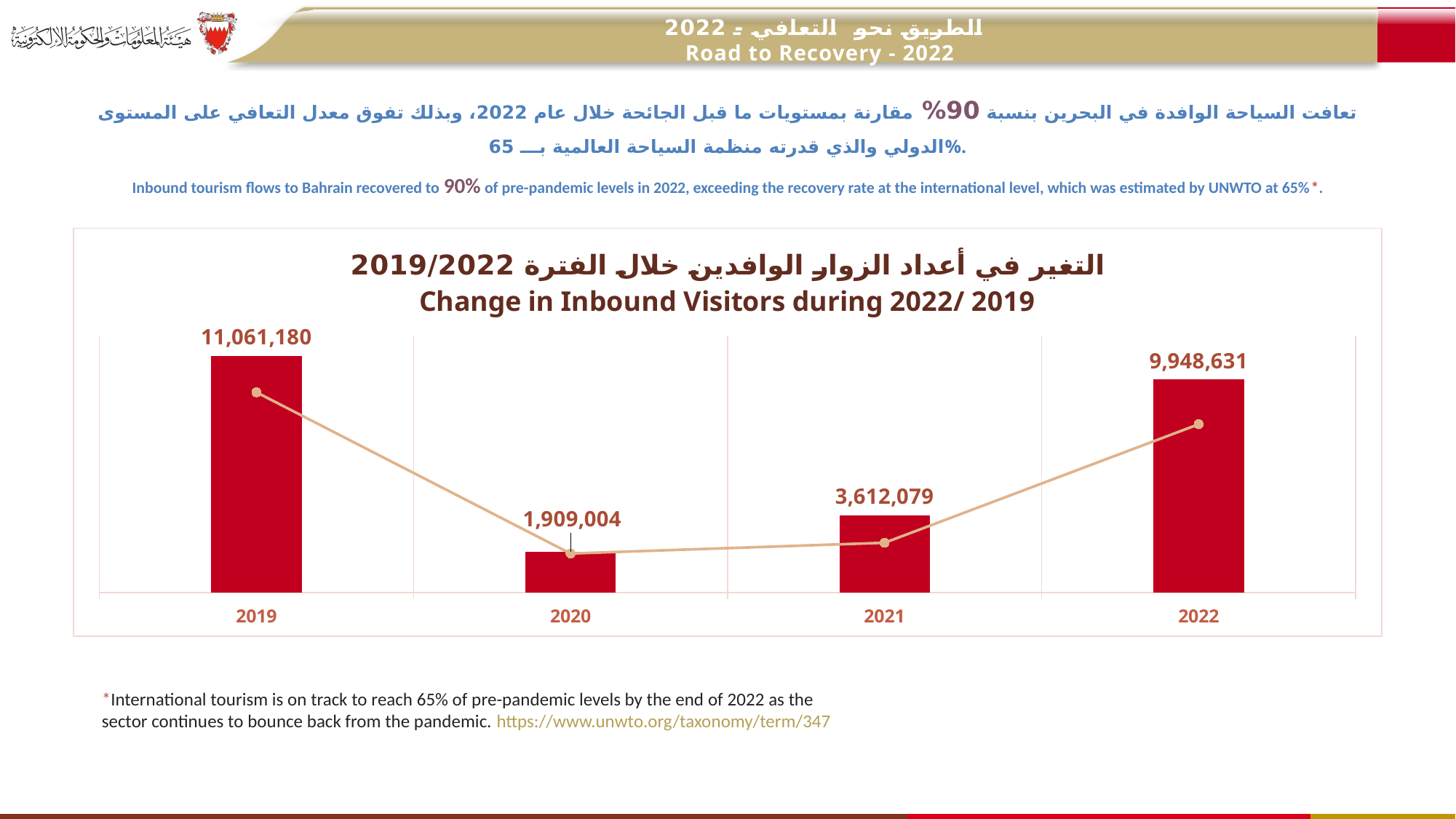
Which year has the highest number of inbound visitors? 2019 Which year has more inbound visitors, 2021 or 2022? 2022 What is the number of inbound visitors shown for 2021? 3,612,079 Which year has the lowest number of inbound visitors? 2020 What is the number of inbound visitors shown for 2020? 1,909,004 What is the difference between the 2021 and 2020 inbound visitor numbers? 1,703,075 How many years are shown on the x axis of the chart? 4 What is the number of inbound visitors shown for 2019? 11,061,180 What is the number of inbound visitors shown for 2022? 9,948,631 What kind of chart is used to show the change in inbound visitors? Bar chart (with a line overlay) What is the English title of the chart? Change in Inbound Visitors during 2022/ 2019 What is the difference between the 2019 and 2022 inbound visitor numbers? 1,112,549